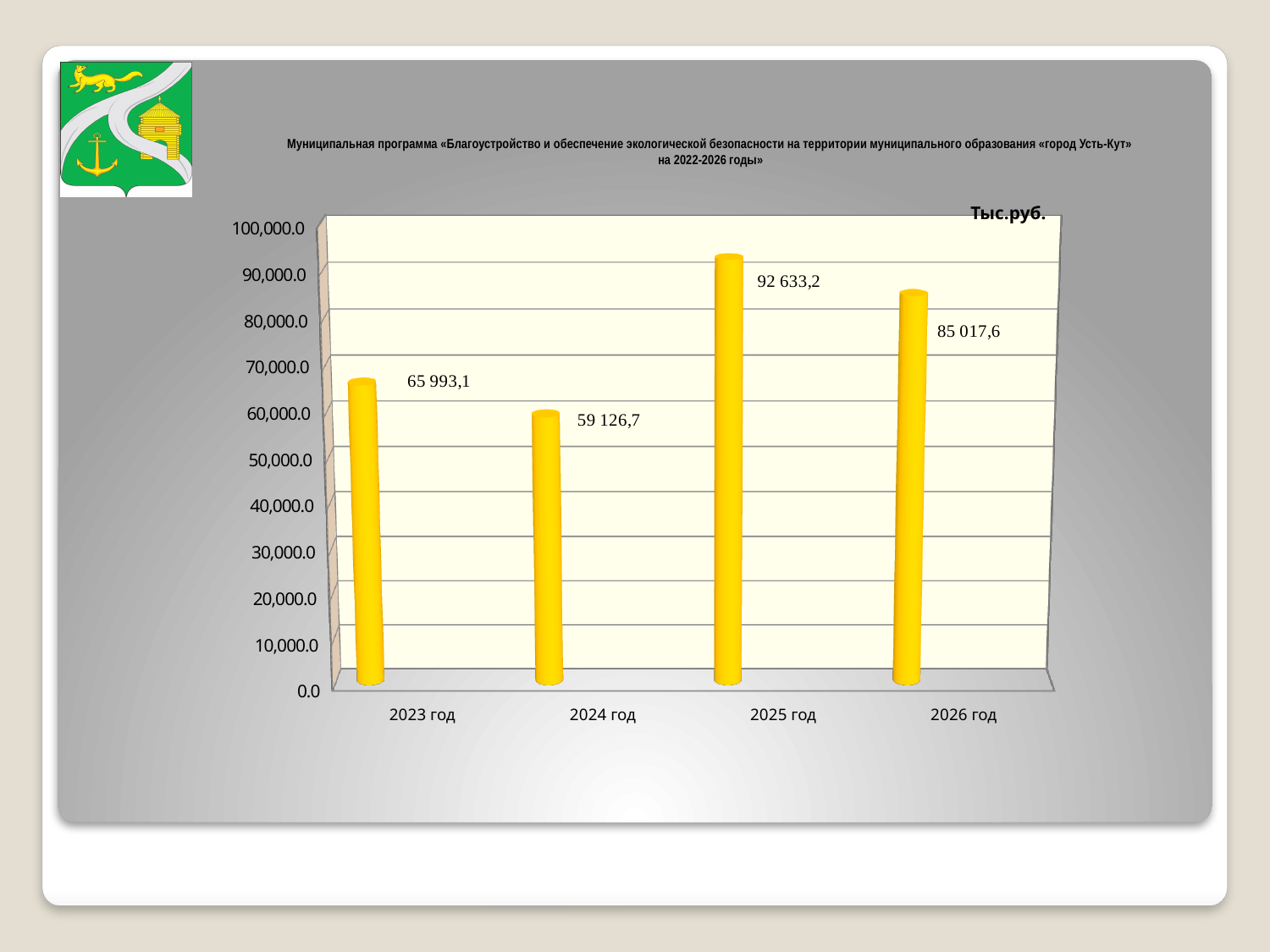
What is the difference between the values for 2023 год and 2024 год? 6 866,4 What is the value for 2024 год? 59 126,7 What is the value for 2025 год? 92 633,2 Which is larger, the value for 2023 год or the value for 2026 год? 2026 год What unit is shown in the top right corner of the chart? Тыс.руб. What is the value for 2023 год? 65 993,1 How many years are shown on the chart? 4 What is the difference between the values for 2025 год and 2026 год? 7 615,6 Which year has the highest value? 2025 год Which year has the lowest value? 2024 год What is the value for 2026 год? 85 017,6 Is the value for 2025 год greater or less than 90,000.0? greater